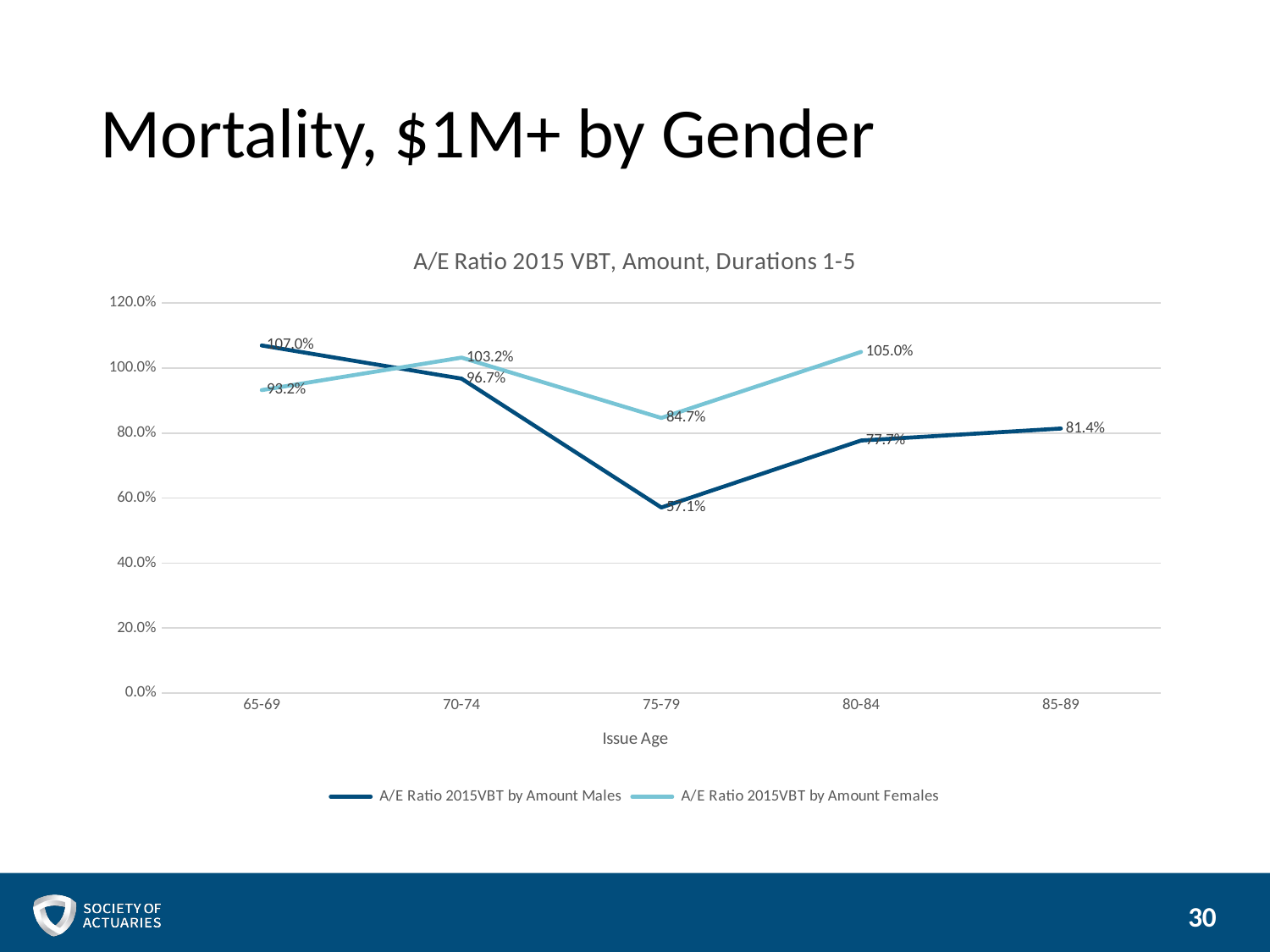
What is the difference between the female and male A/E ratios at issue age 75-79? 27.6% What is the A/E ratio for males at issue age 65-69? 107.0% At issue age 65-69, which series has the higher A/E ratio, males or females? Males What is the A/E ratio for females at issue age 80-84? 105.0% What is the title of the chart? A/E Ratio 2015 VBT, Amount, Durations 1-5 What kind of chart is shown on the slide? Line chart What is the A/E ratio for females at issue age 70-74? 103.2% How many series does the legend list? 2 How many issue age groups are shown on the x axis? 5 At which issue age is the male A/E ratio lowest? 75-79 What is the A/E ratio for males at issue age 75-79? 57.1% At which issue age is the female A/E ratio highest? 80-84